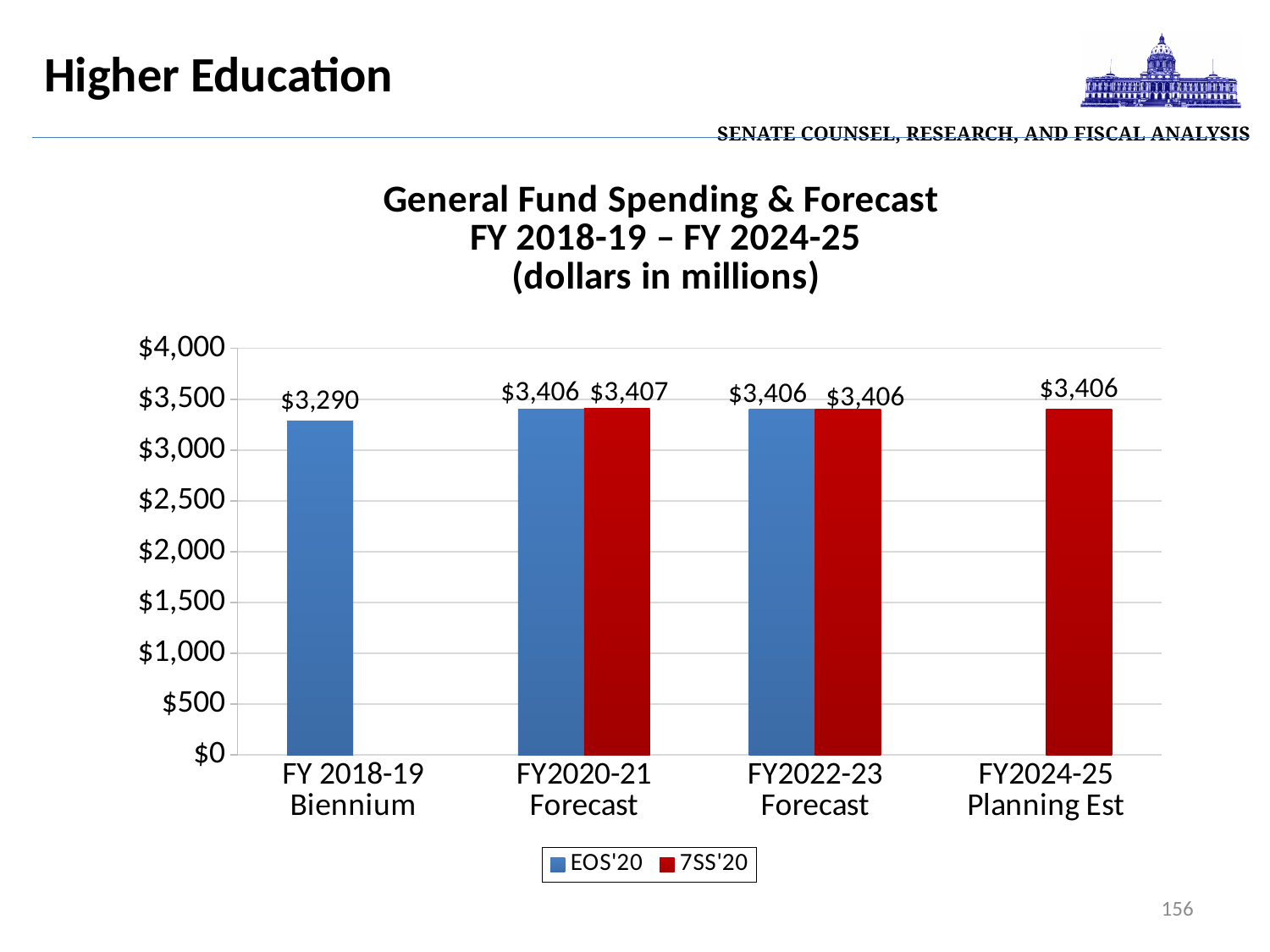
What kind of chart is shown on the slide? bar chart Which series is shown in red in the legend? 7SS'20 Is the EOS'20 value for FY 2018-19 Biennium greater or less than $3,500? less What is the difference between the 7SS'20 value for FY2020-21 Forecast and the 7SS'20 value for FY2024-25 Planning Est? $1 Which category has the lowest EOS'20 value? FY 2018-19 Biennium What is the 7SS'20 value for FY2024-25 Planning Est? $3,406 What is the difference between the EOS'20 values for FY2020-21 Forecast and FY 2018-19 Biennium? $116 What is the 7SS'20 value for FY2020-21 Forecast? $3,407 What is the EOS'20 value for FY 2018-19 Biennium? $3,290 How many categories are shown on the x axis? 4 What is the EOS'20 value for FY2022-23 Forecast? $3,406 How many series does the legend list? 2